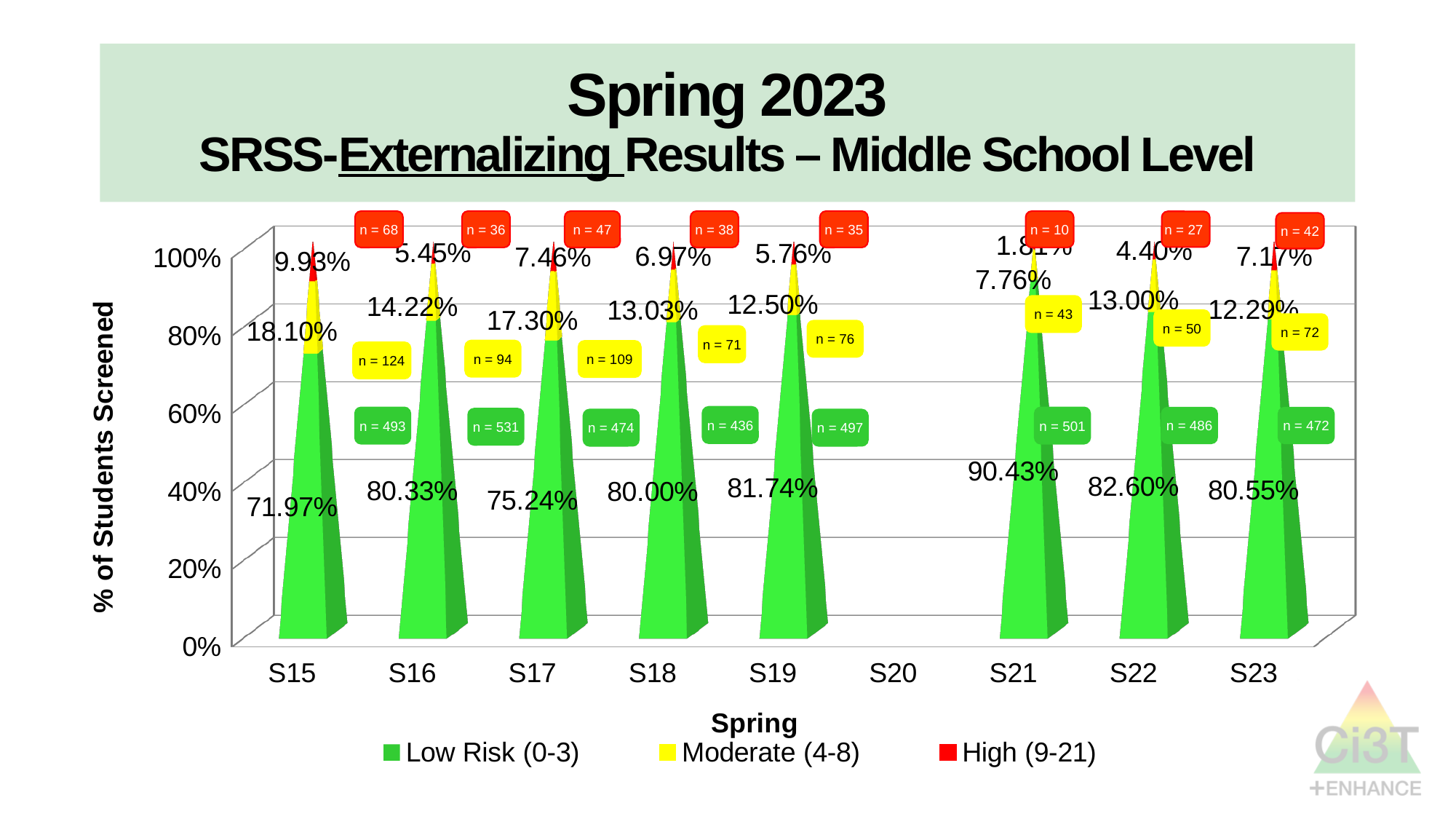
Which spring has the lowest Low Risk (0-3) percentage? S15 What is the n value shown for the Low Risk group in S16? n = 531 Which is larger, the High (9-21) percentage for S17 or for S23? S17 How many series does the legend list? 3 What is the Moderate (4-8) percentage for S23? 12.29% How many springs have data plotted on the chart? 8 Which spring has the highest Low Risk (0-3) percentage? S21 What is the High (9-21) percentage for S15? 9.93% What is the Low Risk (0-3) percentage for S21? 90.43% Which colour represents the Moderate (4-8) group in the legend? Yellow What is the difference between the Low Risk percentages for S21 and S15? 18.46 percentage points What kind of chart is shown on the slide? Stacked bar chart